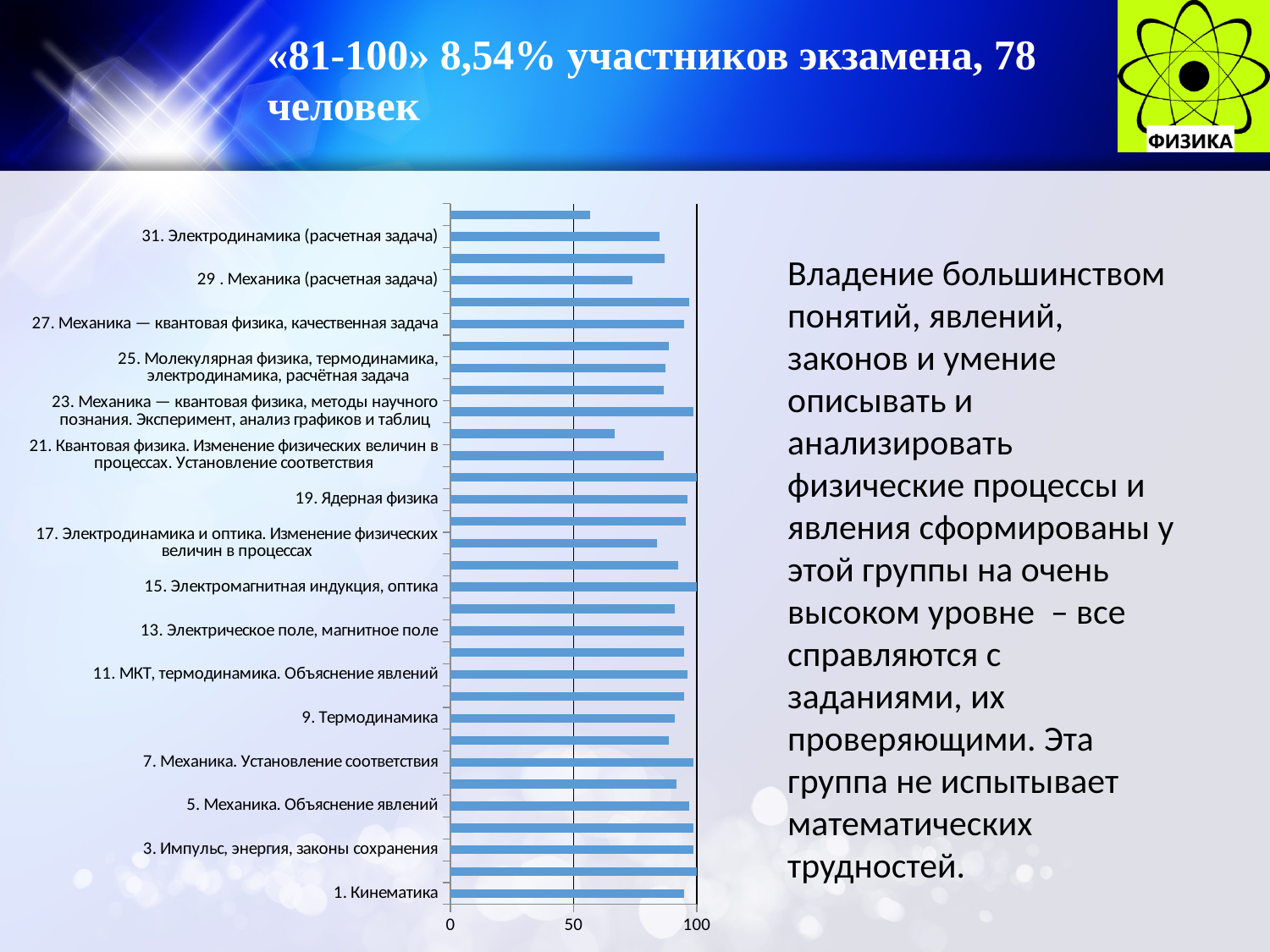
Which has the larger value: "29 . Механика (расчетная задача)" or "27. Механика — квантовая физика, качественная задача"? 27. Механика — квантовая физика, качественная задача Is the value for "29 . Механика (расчетная задача)" greater or less than 100? less What colour are the bars in the chart? blue What is the highest tick value shown on the horizontal axis of the chart? 100 Is the value for "1. Кинематика" greater or less than 50? greater Is the value for "21. Квантовая физика. Изменение физических величин в процессах. Установление соответствия" greater or less than 50? greater How many bars does the chart contain? 32 What kind of chart is shown on the slide? bar chart Which has the larger value: "21. Квантовая физика. Изменение физических величин в процессах. Установление соответствия" or "19. Ядерная физика"? 19. Ядерная физика Which has the larger value: "31. Электродинамика (расчетная задача)" or "29 . Механика (расчетная задача)"? 31. Электродинамика (расчетная задача)